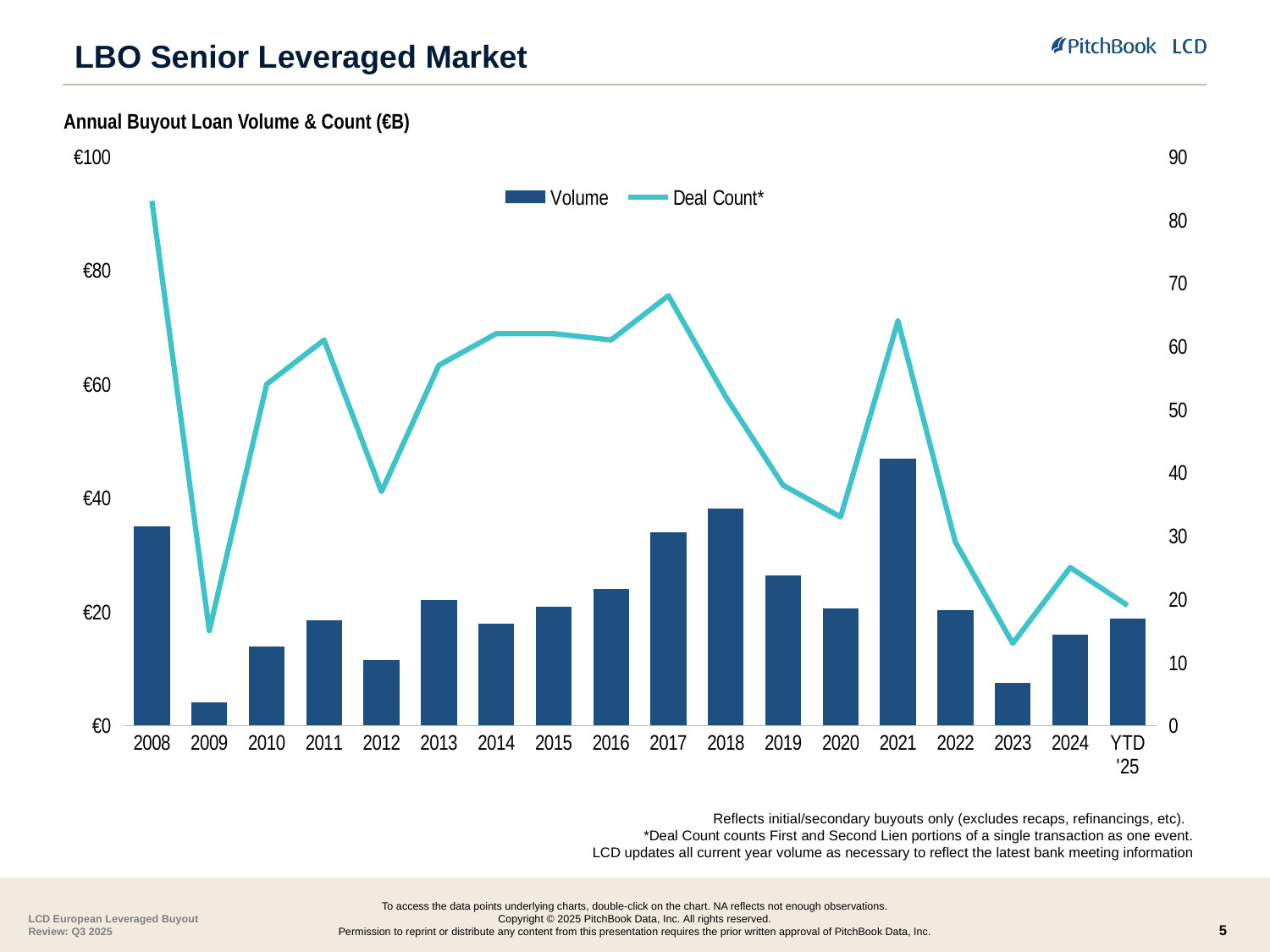
How many series does the legend list? 2 Does the Deal Count line rise or fall from 2021 to 2023? fall Is the Volume for 2009 greater or less than €20? less Is the Deal Count for 2008 greater or less than 80? greater What kind of chart is shown on the slide? A combined bar and line chart In which year is the Deal Count line at its lowest? 2023 Which year has the larger Deal Count, 2008 or 2021? 2008 How many categories are shown on the x axis? 18 In which year is the Deal Count line at its highest? 2008 Which year has the highest Volume bar? 2021 Which year has the lowest Volume bar? 2009 Is the Volume for 2021 greater or less than €40? greater